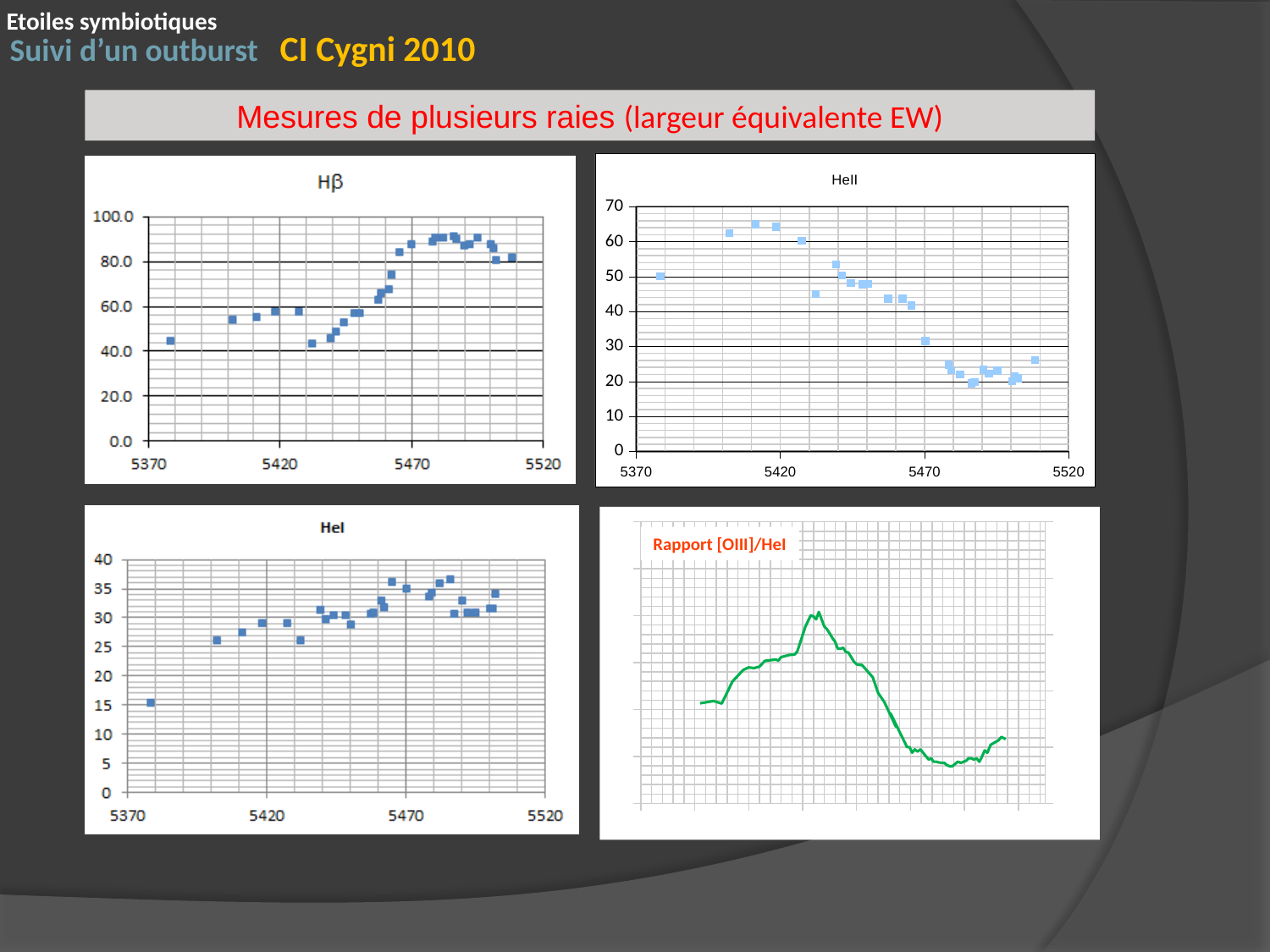
What kind of chart is the Hβ chart at the top left of the slide? scatter chart What kind of chart is the Rapport [OIII]/HeI chart at the bottom right of the slide? line chart In the HeI chart, do the values overall rise or fall as the x axis goes from 5370 to 5520? rise In the HeII chart, are the values of the points near x = 5490 greater or less than 30? less In the HeI chart, is the value of the first point near x = 5380 greater or less than 20? less In the Hβ chart, are the values of the points near x = 5480 greater or less than 80.0? greater In the HeII chart, do the values overall rise or fall as the x axis goes from 5370 to 5520? fall What colour is the line in the Rapport [OIII]/HeI chart? green In the Hβ chart, do the values overall rise or fall as the x axis goes from 5370 to 5520? rise